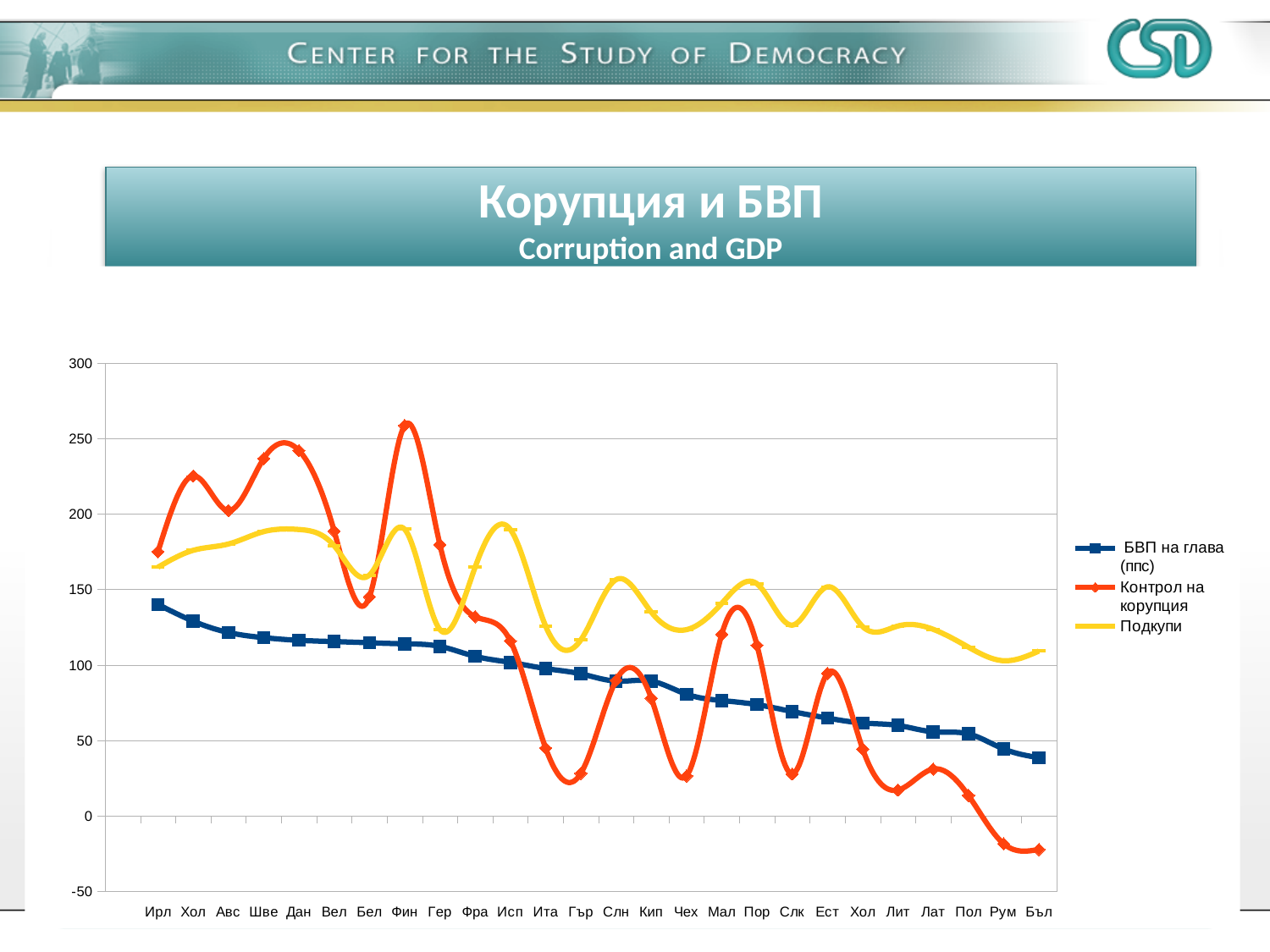
Which category has the highest value for БВП на глава (ппс)? Ирл Does the БВП на глава (ппс) series rise or fall along the x axis from Ирл to Бъл? fall Is the value of БВП на глава (ппс) for Бъл greater or less than 50? less Is the value of Контрол на корупция for Бъл greater or less than 0? less What is the English subtitle of the chart's title box? Corruption and GDP What kind of chart is shown on the slide? line chart Which category has the lowest value for Контрол на корупция? Бъл Which category has the highest value for Контрол на корупция? Фин How many series does the legend list? 3 Is the value of Контрол на корупция for Фин greater or less than 250? greater At Ирл, which is larger: Контрол на корупция or БВП на глава (ппс)? Контрол на корупция How many categories are shown along the x axis? 26